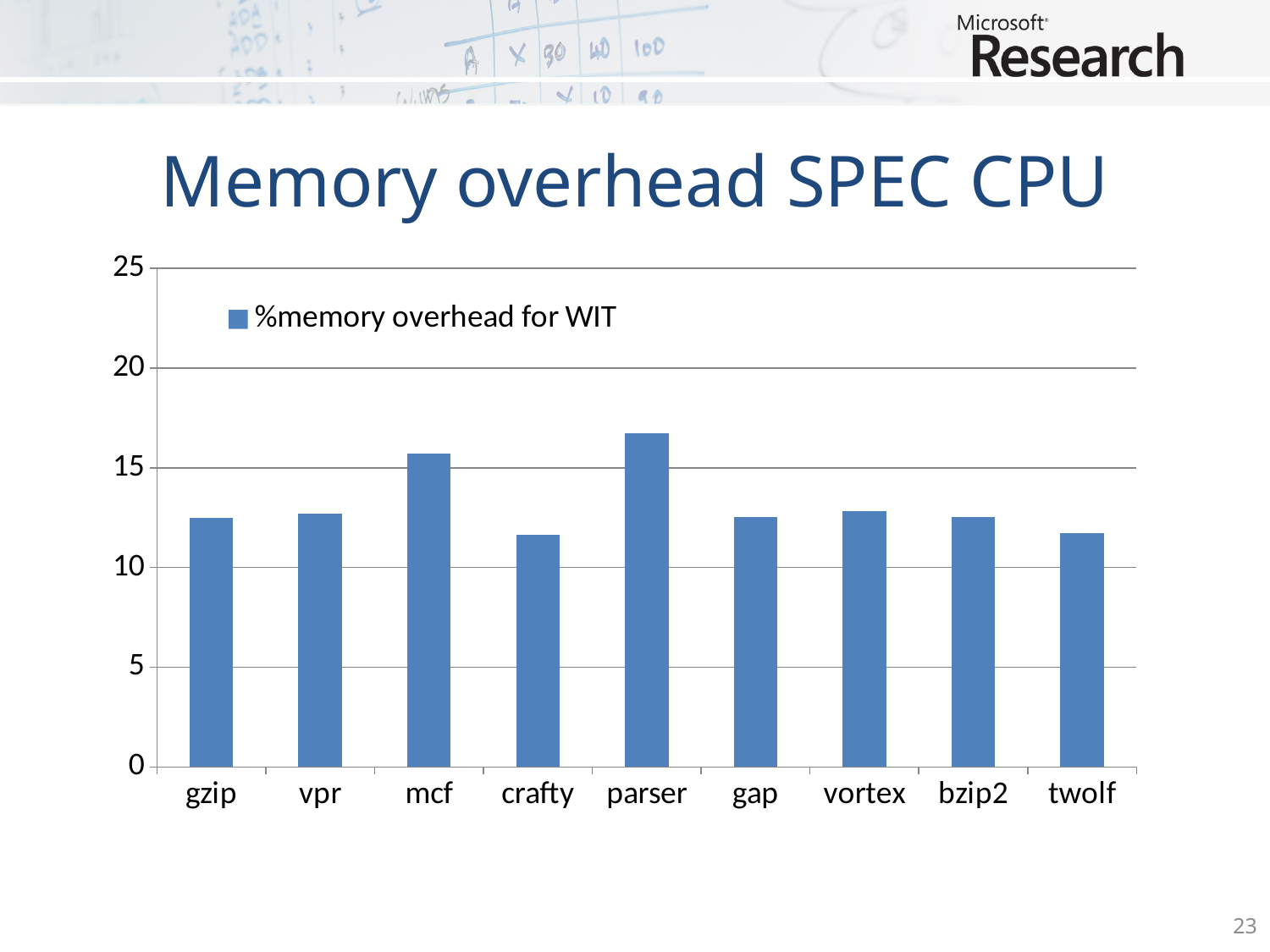
Is the value for parser greater or less than 20? less What is the legend entry for the plotted series? %memory overhead for WIT How many benchmark categories are plotted on the x axis? 9 Which has the larger memory overhead, mcf or crafty? mcf What is the title of the chart? Memory overhead SPEC CPU Is the value for mcf greater or less than 15? greater Which has the larger memory overhead, parser or gzip? parser Is the value for gzip greater or less than 10? greater Which benchmark has the highest memory overhead? parser What kind of chart is shown on the slide? bar chart How many series does the legend list? 1